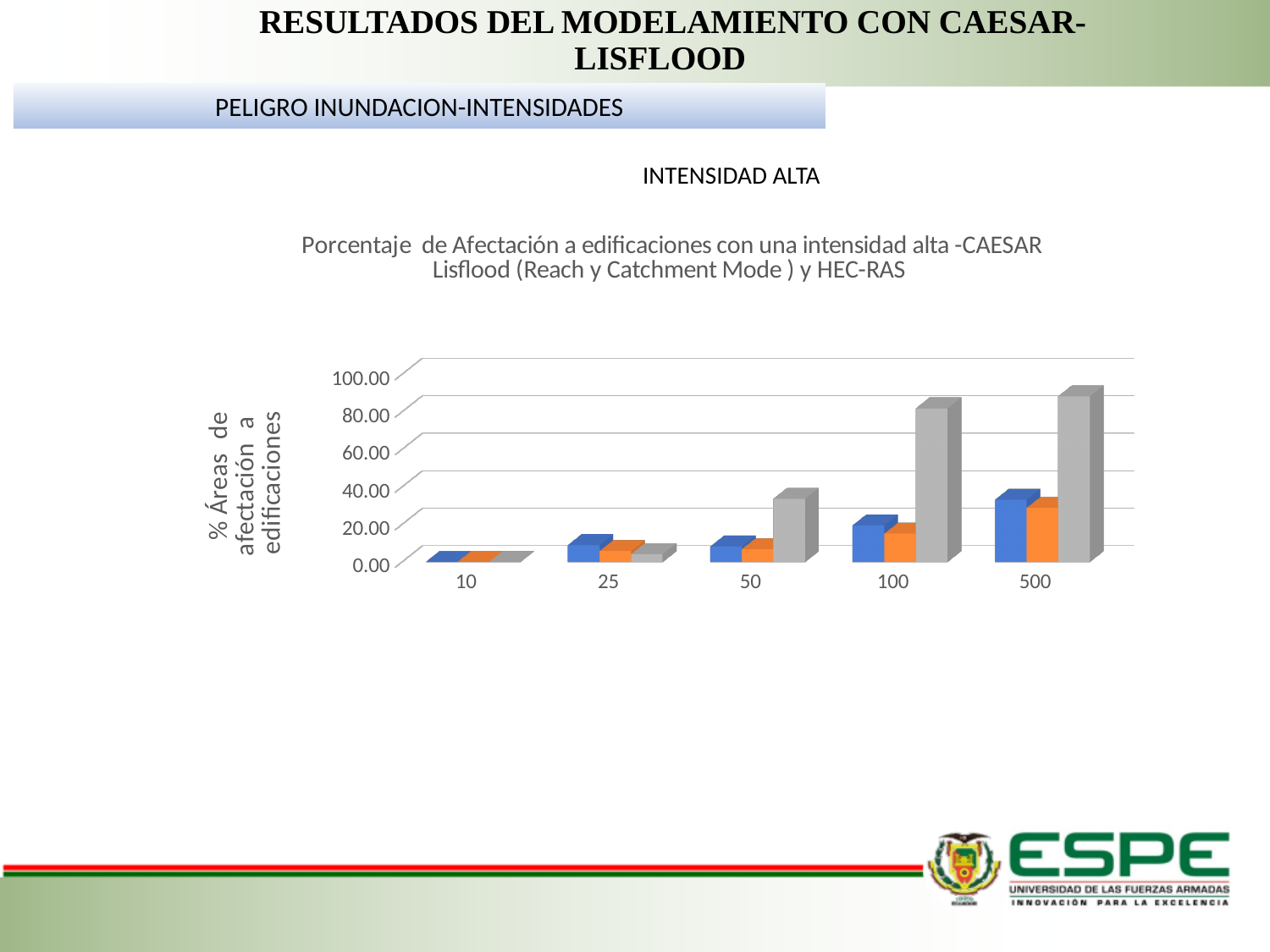
How many bars are plotted for each category in the chart? 3 How many categories are shown on the x axis of the chart? 5 Do the gray bars rise or fall as the categories go from 10 to 500? rise Is the value of the blue bar for category 500 greater or less than 20.00? greater What is the label of the vertical axis of the chart? % Áreas de afectación a edificaciones Which category has the tallest gray bar? 500 Is the value of the gray bar for category 500 greater or less than 60.00? greater Is the value of the blue bar for category 10 greater or less than 20.00? less What kind of chart is shown on the slide? bar chart For category 500, which bar is larger, the gray bar or the blue bar? gray bar Which category has the shortest gray bar? 10